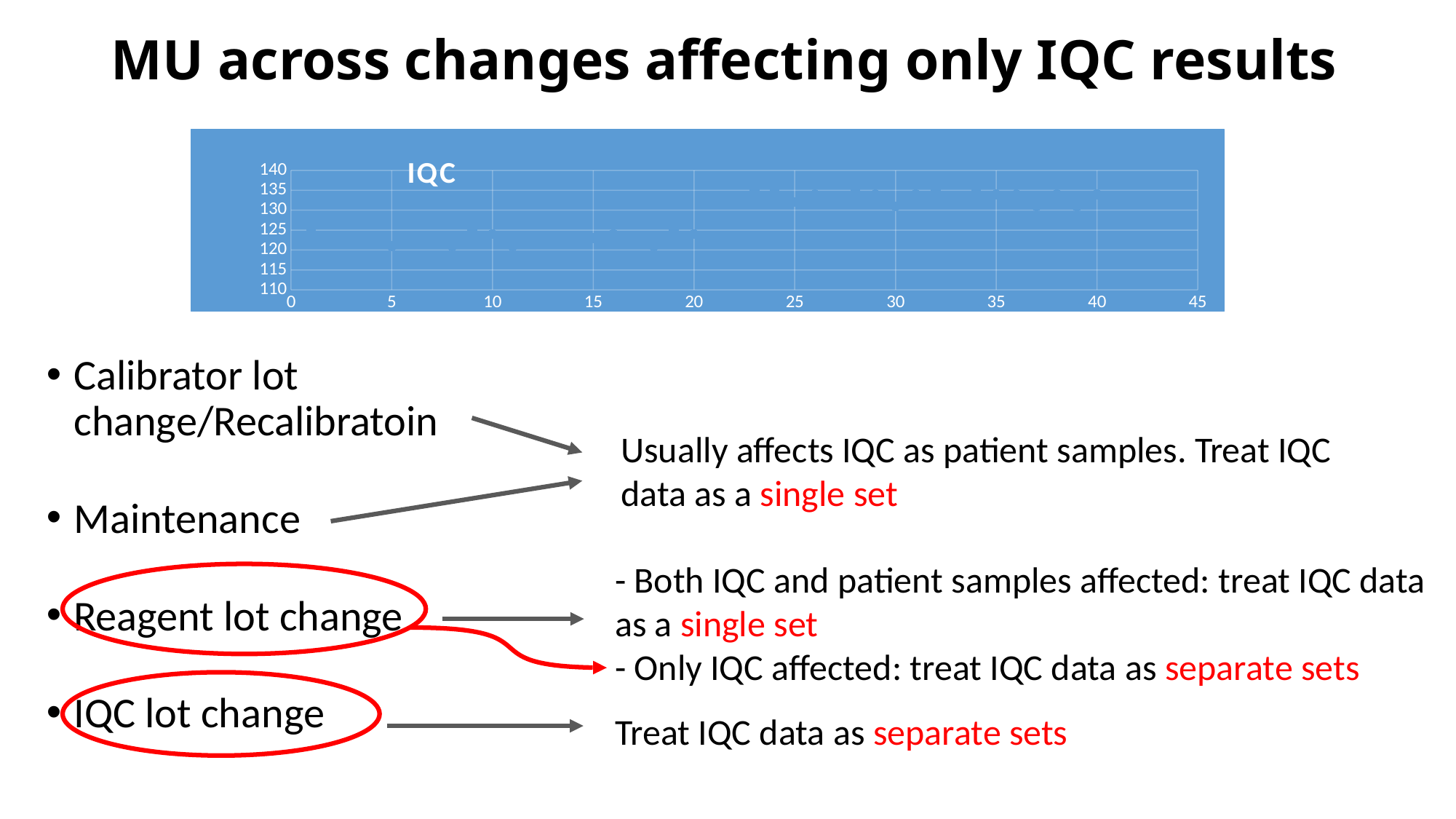
What is the highest value shown on the y axis of the IQC chart? 140 Do the plotted IQC values generally rise or fall as the x axis increases from 0 to 45? rise In the IQC chart, are the plotted values near x = 10 greater or less than 115? greater What is the title of the chart on the slide? IQC In the IQC chart, are the plotted values near x = 5 greater or less than 130? less In the IQC chart, are the plotted values near x = 35 greater or less than 130? greater